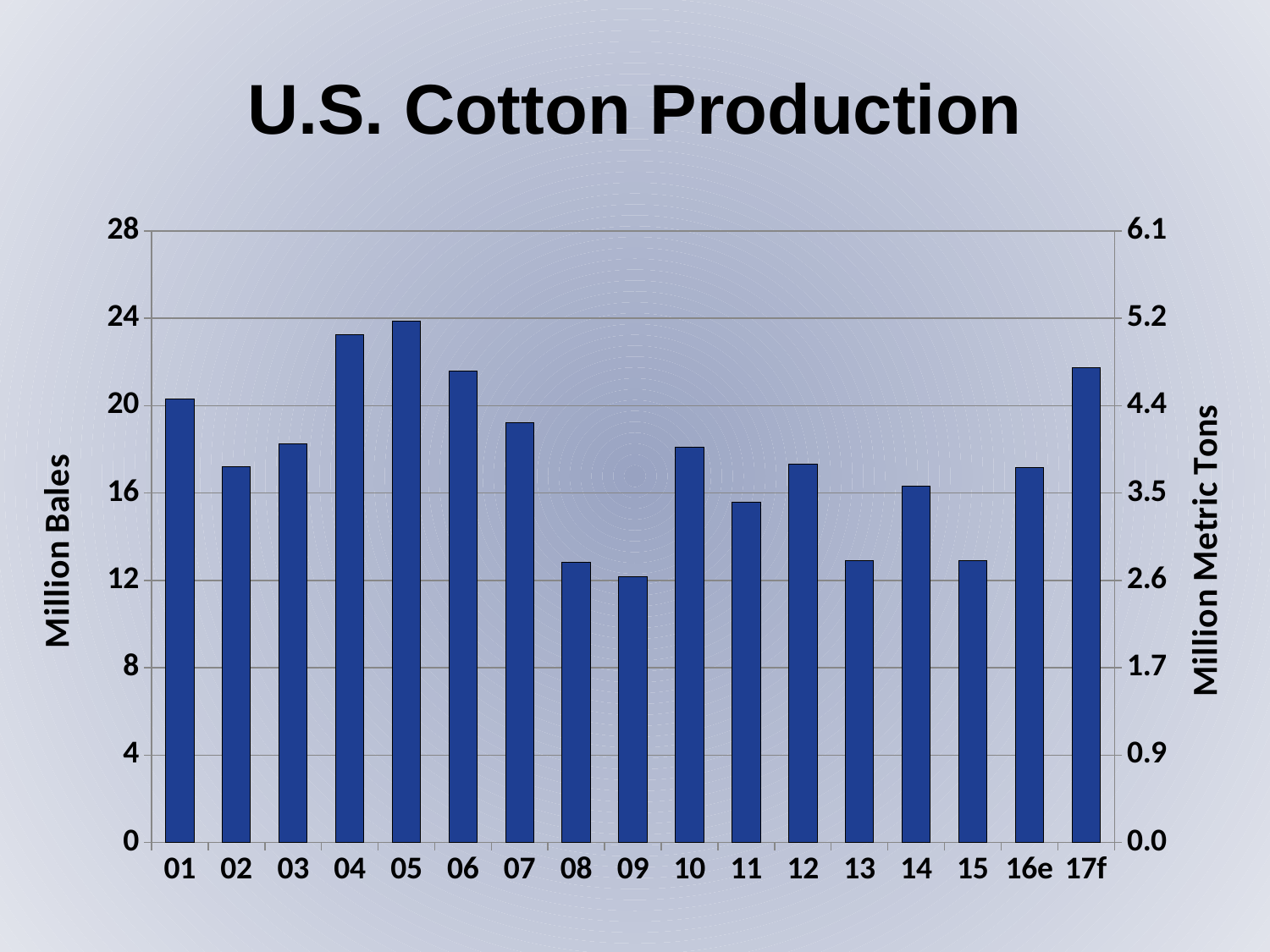
Which year has the lowest cotton production? 09 Which is larger, the value for 17f or the value for 16e? 17f What is the label of the right-hand vertical axis? Million Metric Tons How many bars (years) are plotted in the chart? 17 Do the values rise or fall from 05 to 09? fall What is the title of the chart? U.S. Cotton Production Is the value for 09 greater or less than 16 million bales? less Is the value for 17f greater or less than 20 million bales? greater Is the value for 04 greater or less than 20 million bales? greater What kind of chart is shown on the slide? bar chart Which year has the highest cotton production? 05